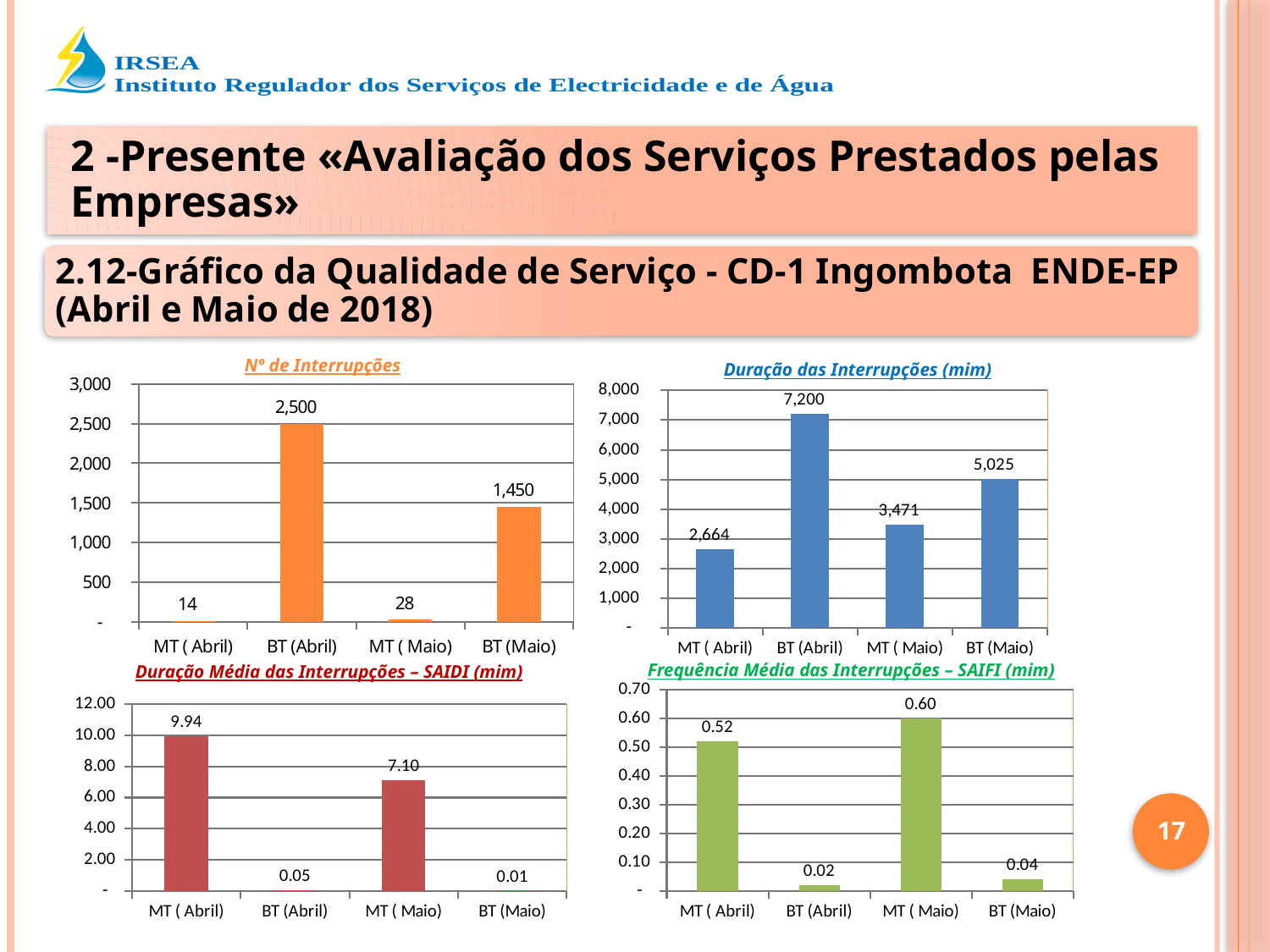
In the 'Duração das Interrupções (mim)' chart, which category has the highest value? BT (Abril) In the 'Nº de Interrupções' chart, which category has the lowest value? MT ( Abril) In the 'Duração das Interrupções (mim)' chart, what is the value for MT ( Maio)? 3,471 In the 'Nº de Interrupções' chart, what is the value for BT (Abril)? 2,500 In the 'Frequência Média das Interrupções – SAIFI (mim)' chart, what is the difference between MT ( Maio) and MT ( Abril)? 0.08 In the 'Duração das Interrupções (mim)' chart, is the value for BT (Maio) greater or less than 4,000? greater In the 'Frequência Média das Interrupções – SAIFI (mim)' chart, what is the value for MT ( Maio)? 0.60 What type of chart is the 'Duração das Interrupções (mim)' chart? Bar chart In the 'Duração Média das Interrupções – SAIDI (mim)' chart, what is the value for MT ( Abril)? 9.94 In the 'Nº de Interrupções' chart, what is the difference between BT (Abril) and BT (Maio)? 1,050 How many categories are shown in the 'Frequência Média das Interrupções – SAIFI (mim)' chart? 4 In the 'Duração Média das Interrupções – SAIDI (mim)' chart, which is larger, MT ( Abril) or MT ( Maio)? MT ( Abril)